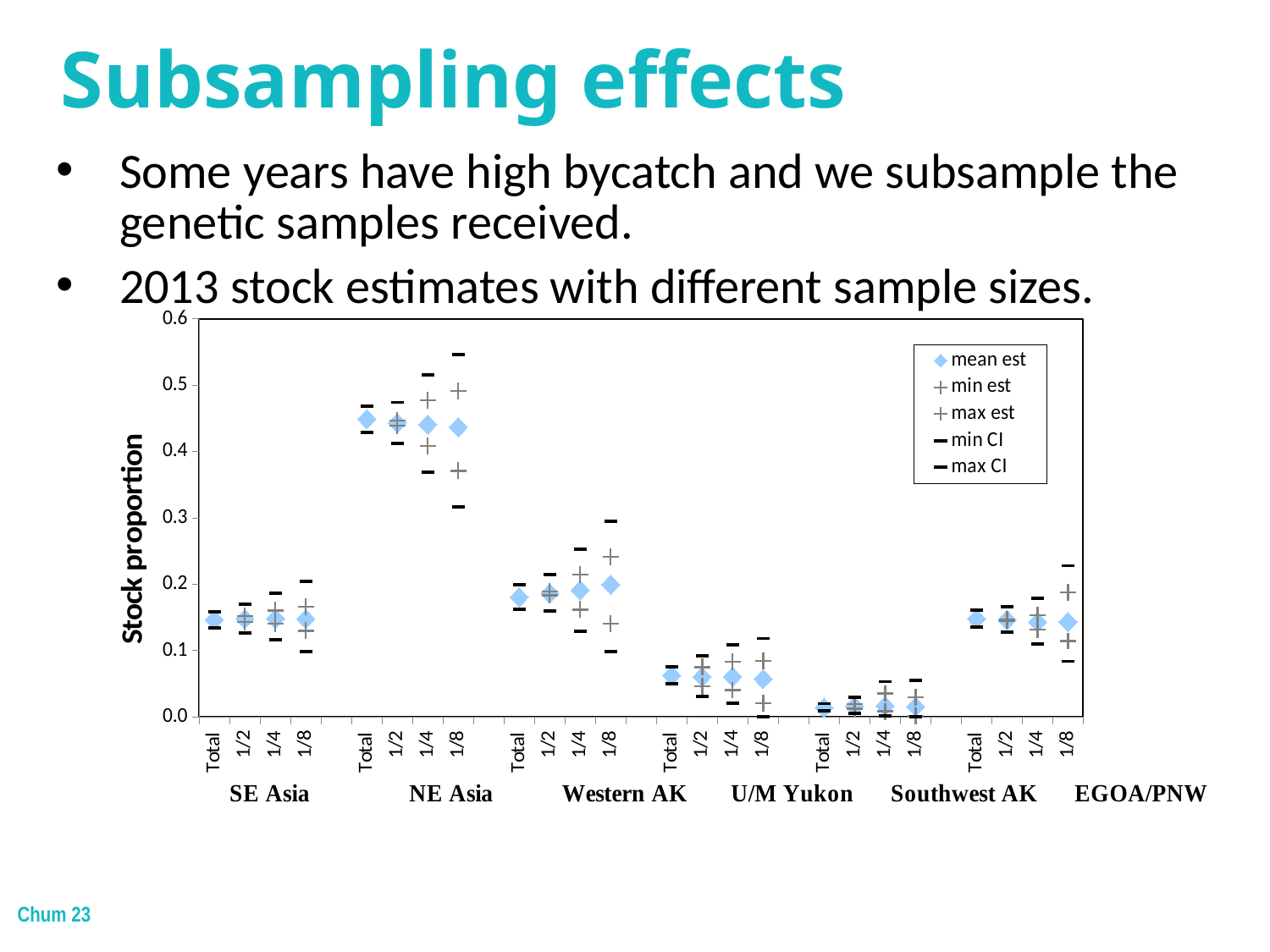
Which regional stock group has the lowest mean estimate of stock proportion? Southwest AK How many regional stock groups are shown along the x axis? 6 Which has a larger mean est value: NE Asia Total or Western AK Total? NE Asia Total Within the NE Asia group, does the gap between min CI and max CI widen or narrow as the subsample goes from Total to 1/8? widens Is the mean est value for the SE Asia Total sample greater or less than 0.1? greater What is the title of the y axis? Stock proportion Is the mean est value for the NE Asia Total sample greater or less than 0.4? greater What kind of chart is shown on the slide? scatter chart Which regional stock group has the highest mean estimate of stock proportion? NE Asia Is the mean est value for the U/M Yukon Total sample greater or less than 0.1? less How many series does the legend list? 5